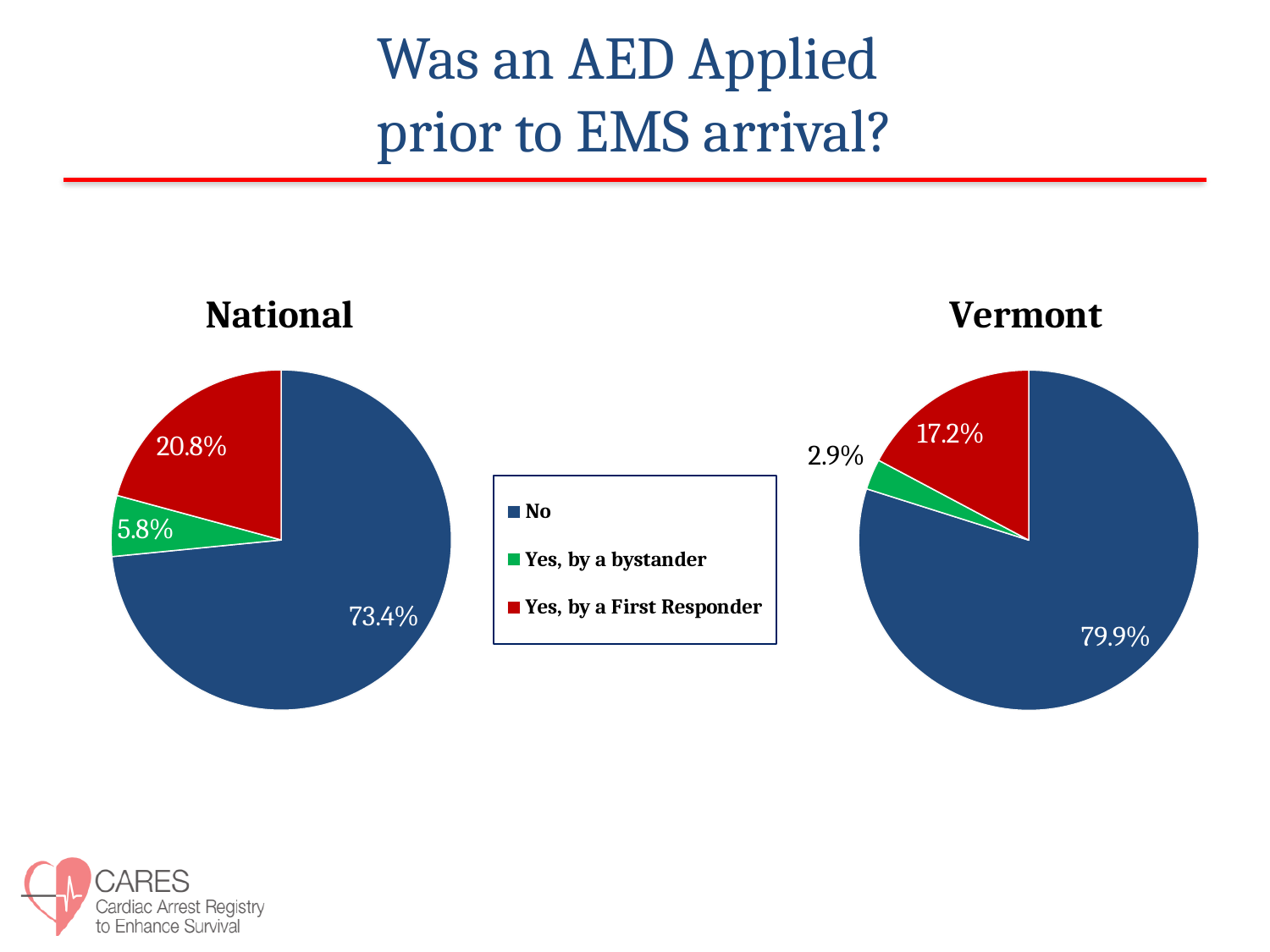
In the National pie chart, what percentage is shown for "No"? 73.4% What type of chart is used for the Vermont data? Pie chart In the Vermont pie chart, what percentage is shown for "Yes, by a bystander"? 2.9% In the Vermont pie chart, what percentage is shown for "No"? 79.9% Which chart shows a larger percentage for "Yes, by a First Responder", National or Vermont? National In the Vermont pie chart, which category has the largest slice? No In the National pie chart, which category has the smallest slice? Yes, by a bystander How many series does the legend list? 3 How many slices does the National pie chart have? 3 In the National pie chart, what percentage is shown for "Yes, by a First Responder"? 20.8% What is the difference between the "No" percentage in the Vermont chart and the "No" percentage in the National chart? 6.5% What colour represents "Yes, by a bystander" in the legend? Green